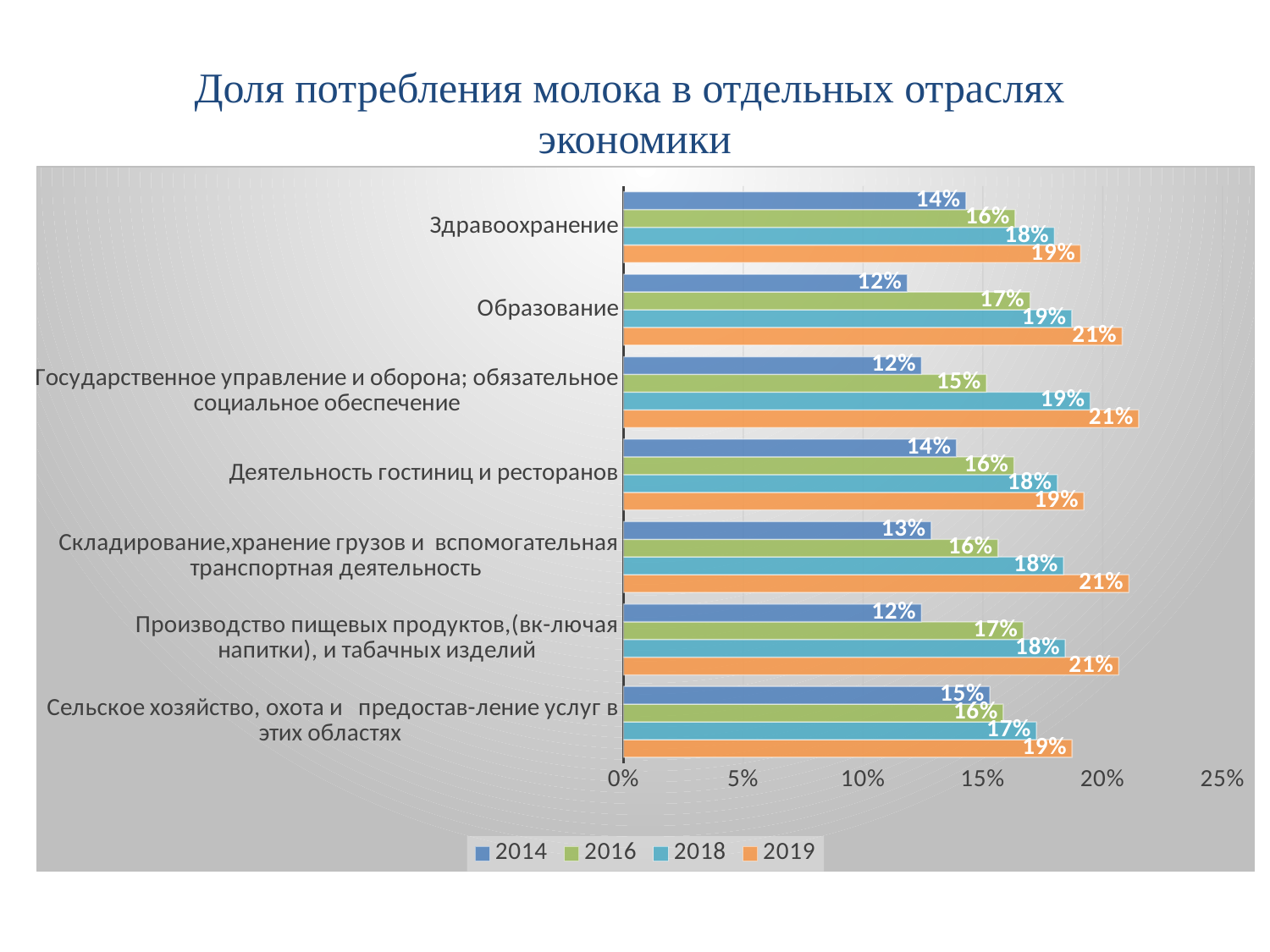
Which is larger for Деятельность гостиниц и ресторанов: the 2016 value or the 2018 value? 2018 What is the value for Образование in 2014? 12% How many series does the legend list? 4 Do the values for Складирование, хранение грузов и вспомогательная транспортная деятельность rise or fall from 2014 to 2019? rise Which category has the highest value in 2014? Сельское хозяйство, охота и предоставление услуг в этих областях How many categories (industries) are shown on the chart? 7 Which category has the lowest value in 2016? Государственное управление и оборона; обязательное социальное обеспечение What is the value for Здравоохранение in 2019? 19% What type of chart is shown on the slide? bar chart What is the title of the chart? Доля потребления молока в отдельных отраслях экономики What is the difference between the 2019 and 2014 values for Образование? 9% What is the value for Сельское хозяйство, охота и предоставление услуг в этих областях in 2018? 17%